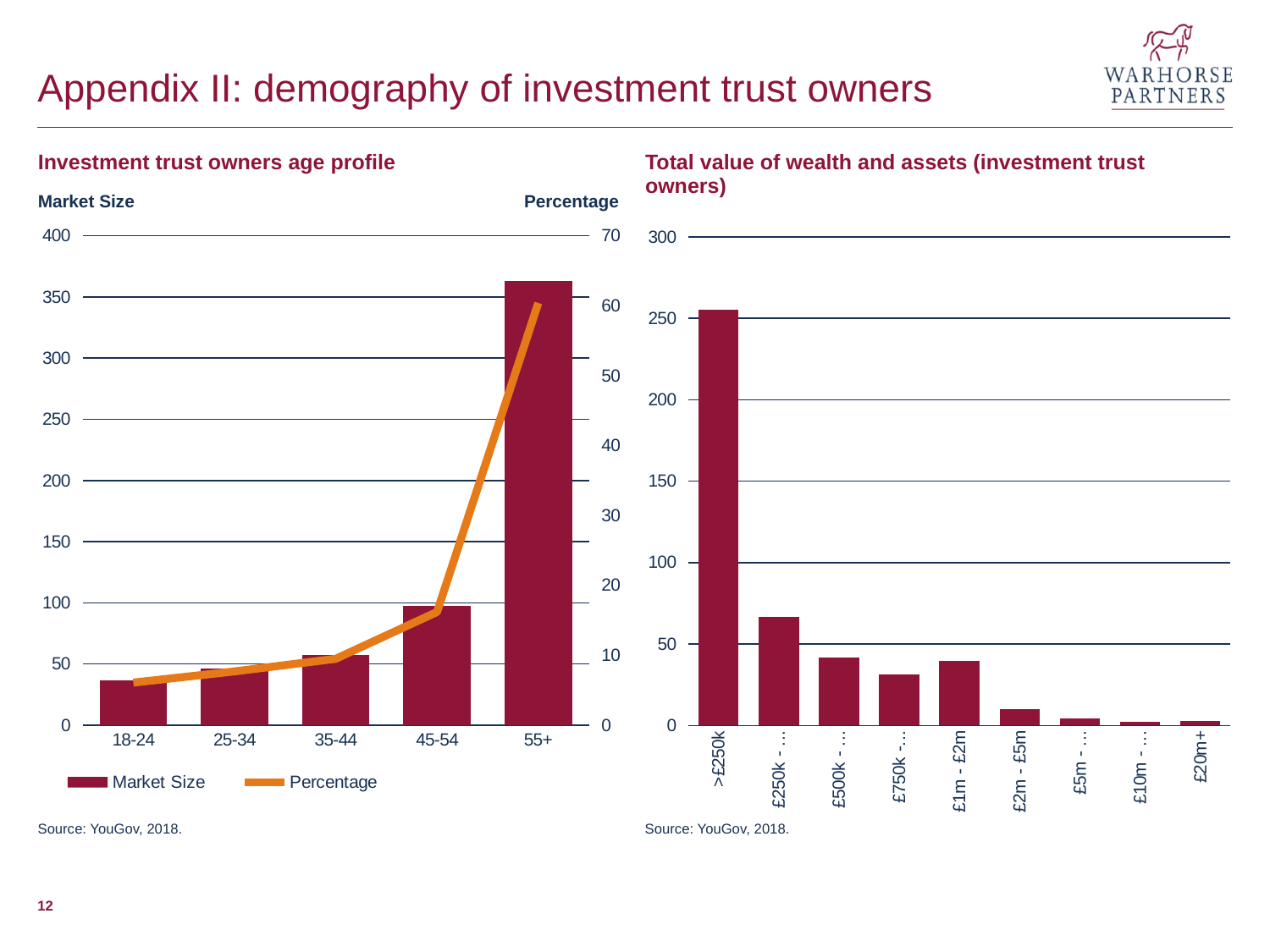
In the 'Investment trust owners age profile' chart, is the Percentage for 55+ greater or less than 50? greater In the 'Investment trust owners age profile' chart, which age group has the lowest Market Size? 18-24 How many series does the legend of the 'Investment trust owners age profile' chart list? 2 In the 'Investment trust owners age profile' chart, does Market Size rise or fall as age increases along the x axis? rise In the 'Total value of wealth and assets (investment trust owners)' chart, is the value for £1m - £2m greater or less than 50? less In the 'Investment trust owners age profile' chart, is the Market Size for 45-54 greater or less than 150? less How many bars are shown in the 'Total value of wealth and assets (investment trust owners)' chart? 9 In the 'Total value of wealth and assets (investment trust owners)' chart, which category has the highest value? >£250k What kind of chart is the 'Total value of wealth and assets (investment trust owners)' chart? bar chart How many age categories are shown on the x axis of the 'Investment trust owners age profile' chart? 5 In the 'Investment trust owners age profile' chart, which age group has the highest Market Size? 55+